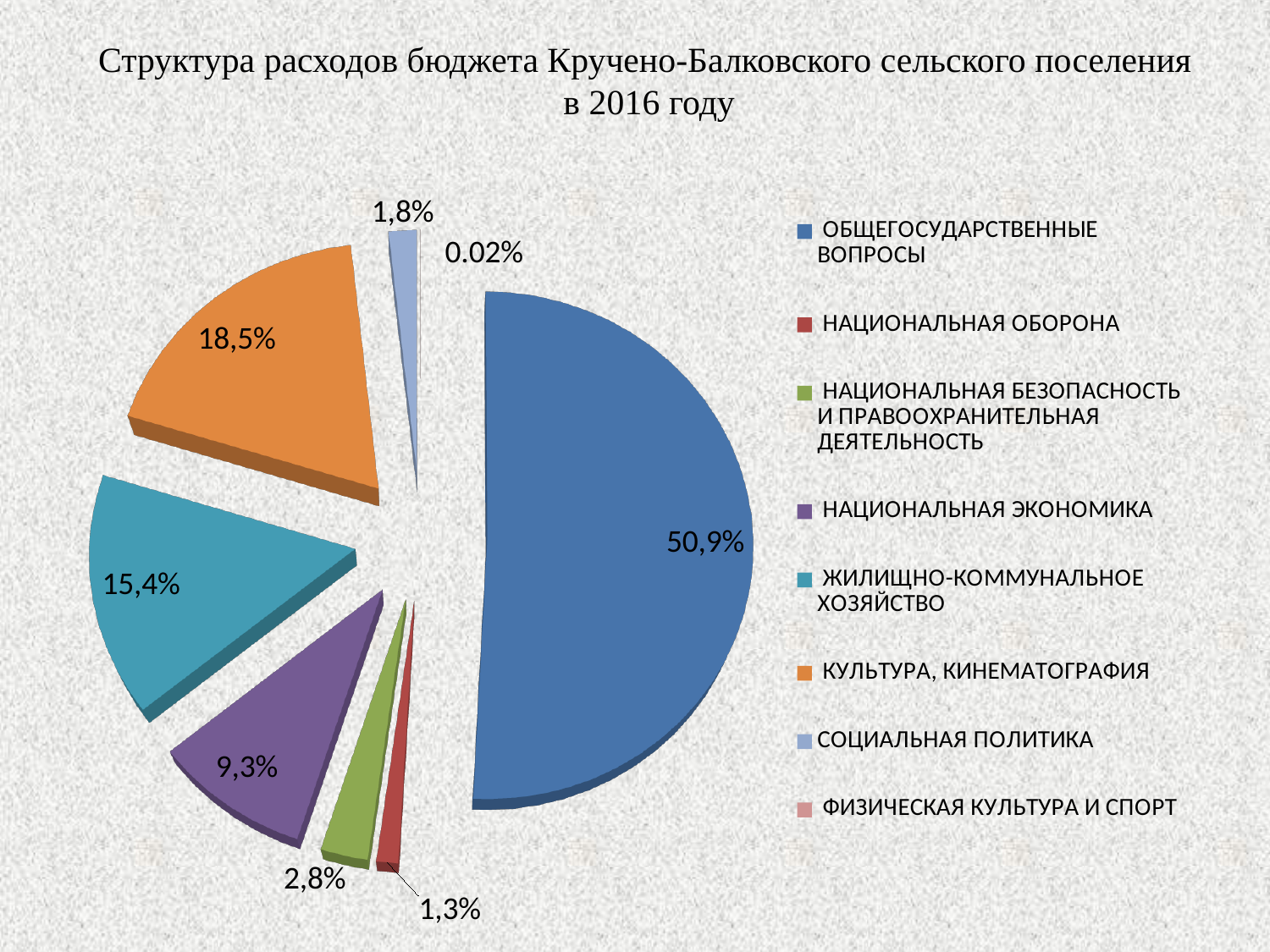
What share is shown for СОЦИАЛЬНАЯ ПОЛИТИКА? 1,8% Which has a larger share: НАЦИОНАЛЬНАЯ ОБОРОНА or НАЦИОНАЛЬНАЯ БЕЗОПАСНОСТЬ И ПРАВООХРАНИТЕЛЬНАЯ ДЕЯТЕЛЬНОСТЬ? НАЦИОНАЛЬНАЯ БЕЗОПАСНОСТЬ И ПРАВООХРАНИТЕЛЬНАЯ ДЕЯТЕЛЬНОСТЬ Which expenditure category has the smallest share of the budget? ФИЗИЧЕСКАЯ КУЛЬТУРА И СПОРТ How many expenditure categories does the legend list? 8 What colour is the slice for НАЦИОНАЛЬНАЯ ЭКОНОМИКА? Purple What share is shown for НАЦИОНАЛЬНАЯ ЭКОНОМИКА? 9,3% Which expenditure category has the largest share of the budget? ОБЩЕГОСУДАРСТВЕННЫЕ ВОПРОСЫ What is the difference in percentage points between КУЛЬТУРА, КИНЕМАТОГРАФИЯ and ЖИЛИЩНО-КОММУНАЛЬНОЕ ХОЗЯЙСТВО? 3,1 What share is shown for КУЛЬТУРА, КИНЕМАТОГРАФИЯ? 18,5% What type of chart is shown on the slide? Pie chart What share of the budget expenditure goes to ОБЩЕГОСУДАРСТВЕННЫЕ ВОПРОСЫ? 50,9% What share is shown for ЖИЛИЩНО-КОММУНАЛЬНОЕ ХОЗЯЙСТВО? 15,4%